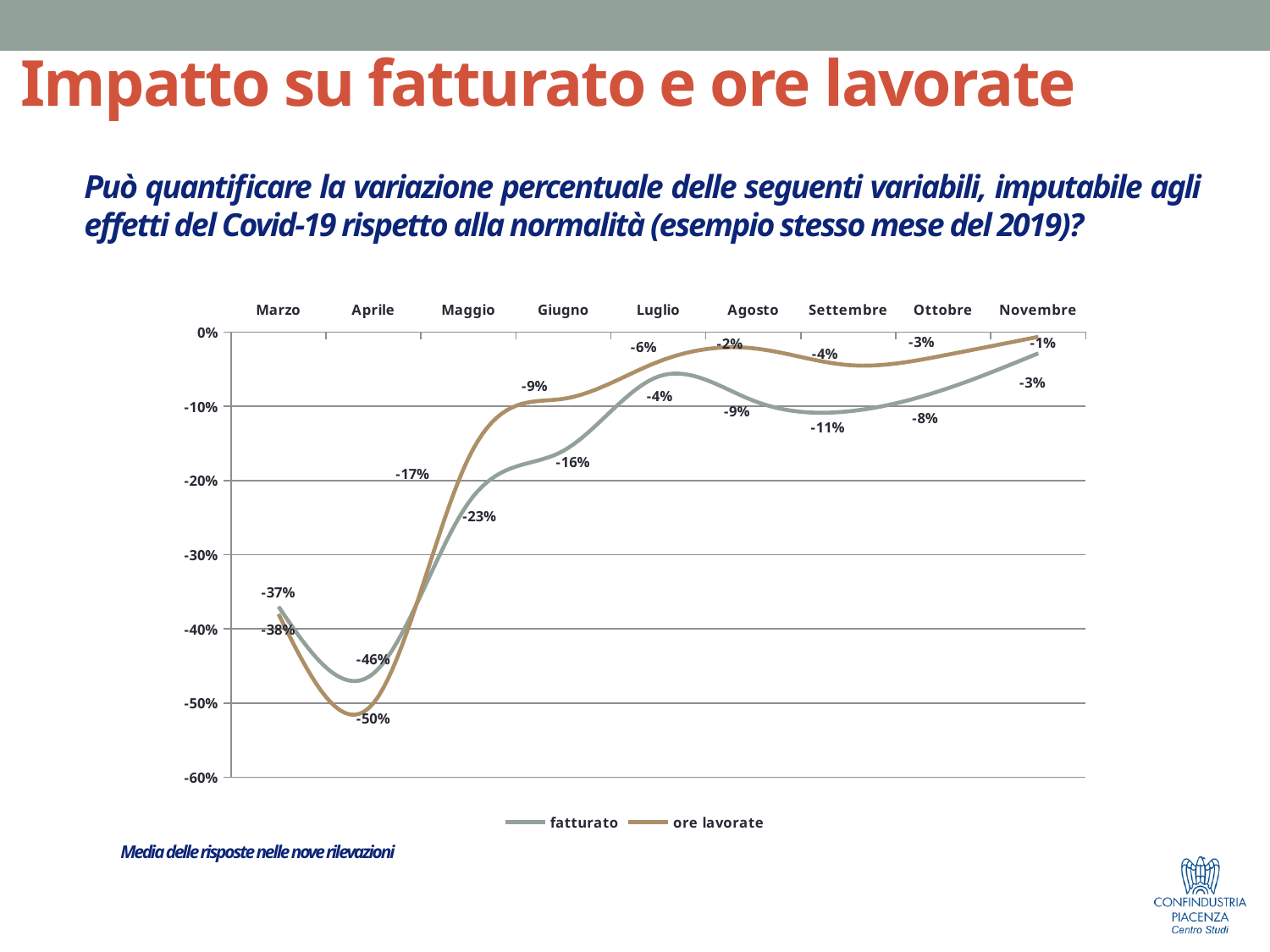
In Maggio, which series has the higher (less negative) value, fatturato or ore lavorate? ore lavorate What are the two series named in the legend? fatturato and ore lavorate From Aprile to Novembre, do the values for ore lavorate generally rise or fall? Rise What kind of chart is shown on the slide? Line chart What is the difference between fatturato (-46%) and ore lavorate (-50%) in Aprile? 4 percentage points What is the value for ore lavorate in Novembre? -1% How many months are plotted along the x axis? 9 What is the value for fatturato in Aprile? -46% How many series does the legend list? 2 In which month does fatturato reach its lowest value? Aprile What is the value for ore lavorate in Aprile? -50% What is the value for fatturato in Settembre? -11%